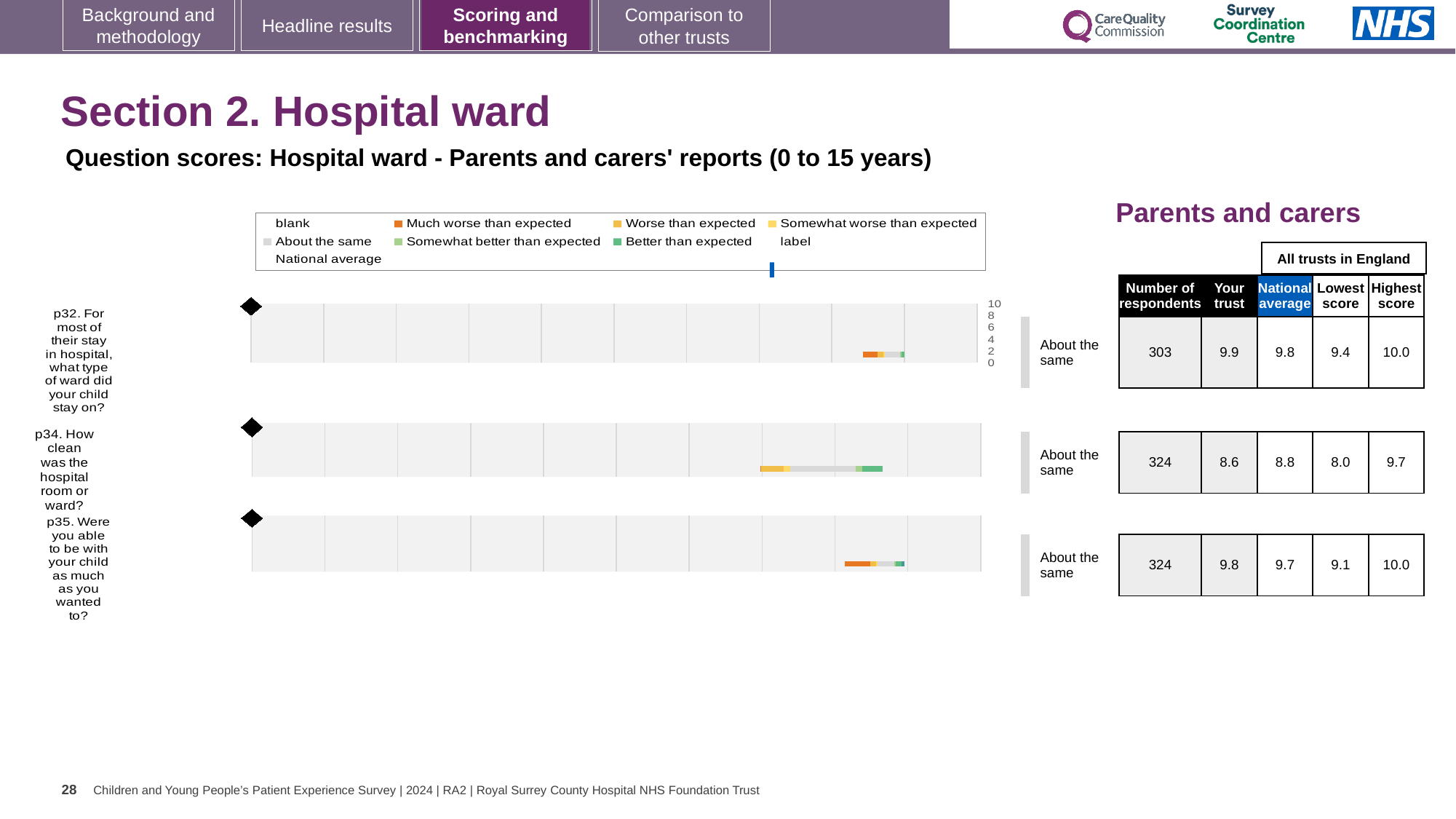
What is the difference between the highest score and the lowest score for question p34? 1.7 What benchmark category is shown for all three questions on this slide? About the same Which question has the lowest 'Your trust' score on this slide? p34 What is the 'Your trust' score for question p32 (what type of ward did your child stay on)? 9.9 Which question has the fewest respondents on this slide? p32 What is the lowest score across all trusts in England for question p32? 9.4 What is the national average score for question p35 (were you able to be with your child as much as you wanted to)? 9.7 By how much does the 'Your trust' score for p35 exceed the national average? 0.1 How many respondents are shown for question p34 (How clean was the hospital room or ward)? 324 How many questions are charted on this slide? 3 For question p32, which is larger: the 'Your trust' score or the national average? Your trust What is the highest score across all trusts in England for question p34? 9.7